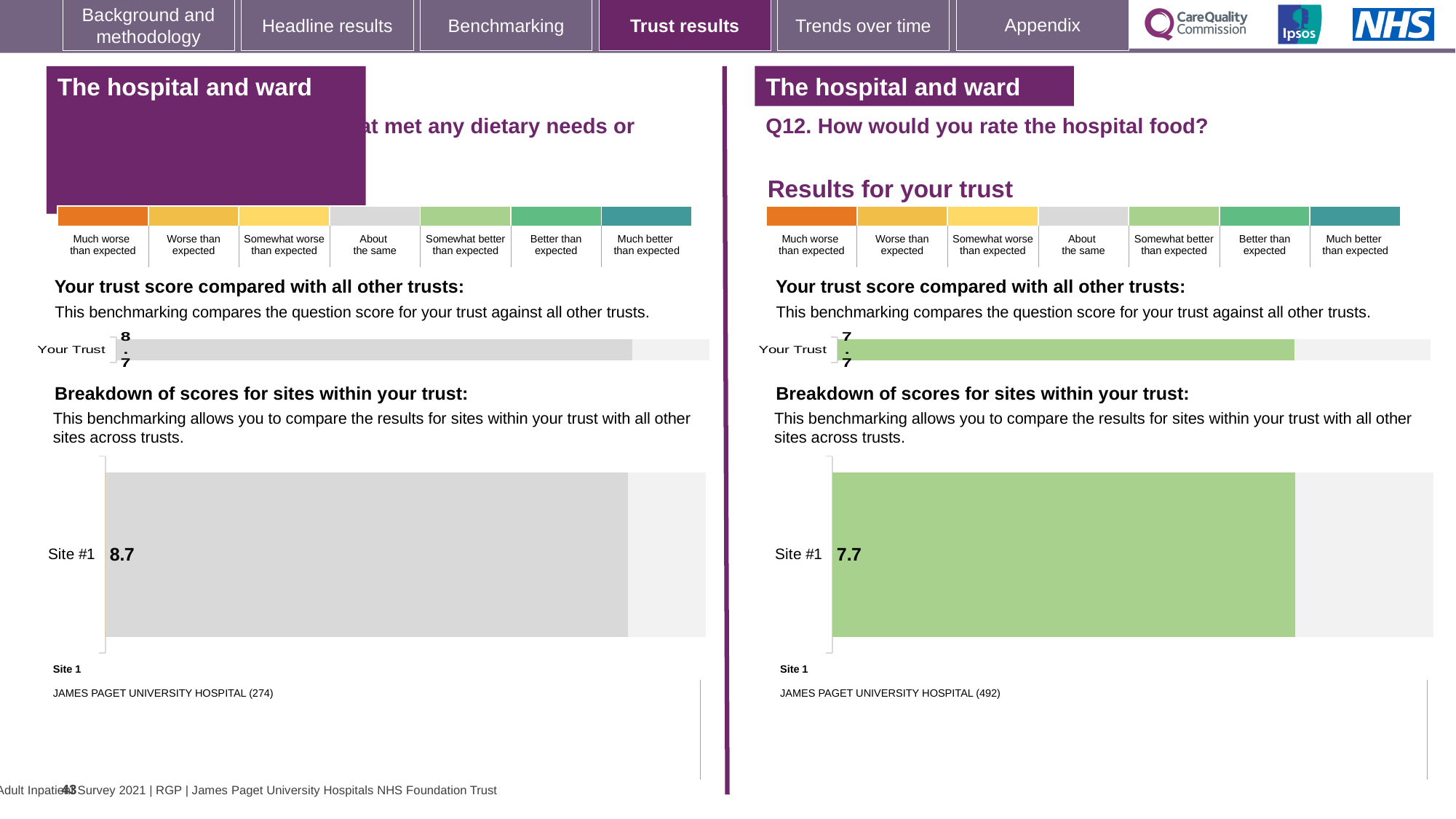
What is the difference between the Site #1 score on the left-hand chart and the Site #1 score on the right-hand chart for Q12? 1.0 On the left-hand chart, what is the score shown for Your Trust? 8.7 Which site name is listed as Site 1 beneath the right-hand chart for Q12? JAMES PAGET UNIVERSITY HOSPITAL (492) Which is larger: the Site #1 score on the left-hand chart or the Site #1 score on the right-hand chart for Q12? Left-hand chart (8.7) On the left-hand chart, which benchmark category does the grey colour of the Site #1 bar correspond to in the key? About the same How many sites are shown in the breakdown of scores on the right-hand chart for Q12? 1 On the left-hand chart, what is the score shown for Site #1? 8.7 How many sites are shown in the breakdown of scores on the left-hand chart? 1 What kind of chart is used to show the breakdown of scores for sites within your trust on the right-hand side? Bar chart On the right-hand chart for Q12 (How would you rate the hospital food?), what is the score shown for Site #1? 7.7 On the right-hand chart for Q12 (How would you rate the hospital food?), what is the score shown for Your Trust? 7.7 On the right-hand chart for Q12, which benchmark category does the green colour of the Site #1 bar correspond to in the key? Somewhat better than expected